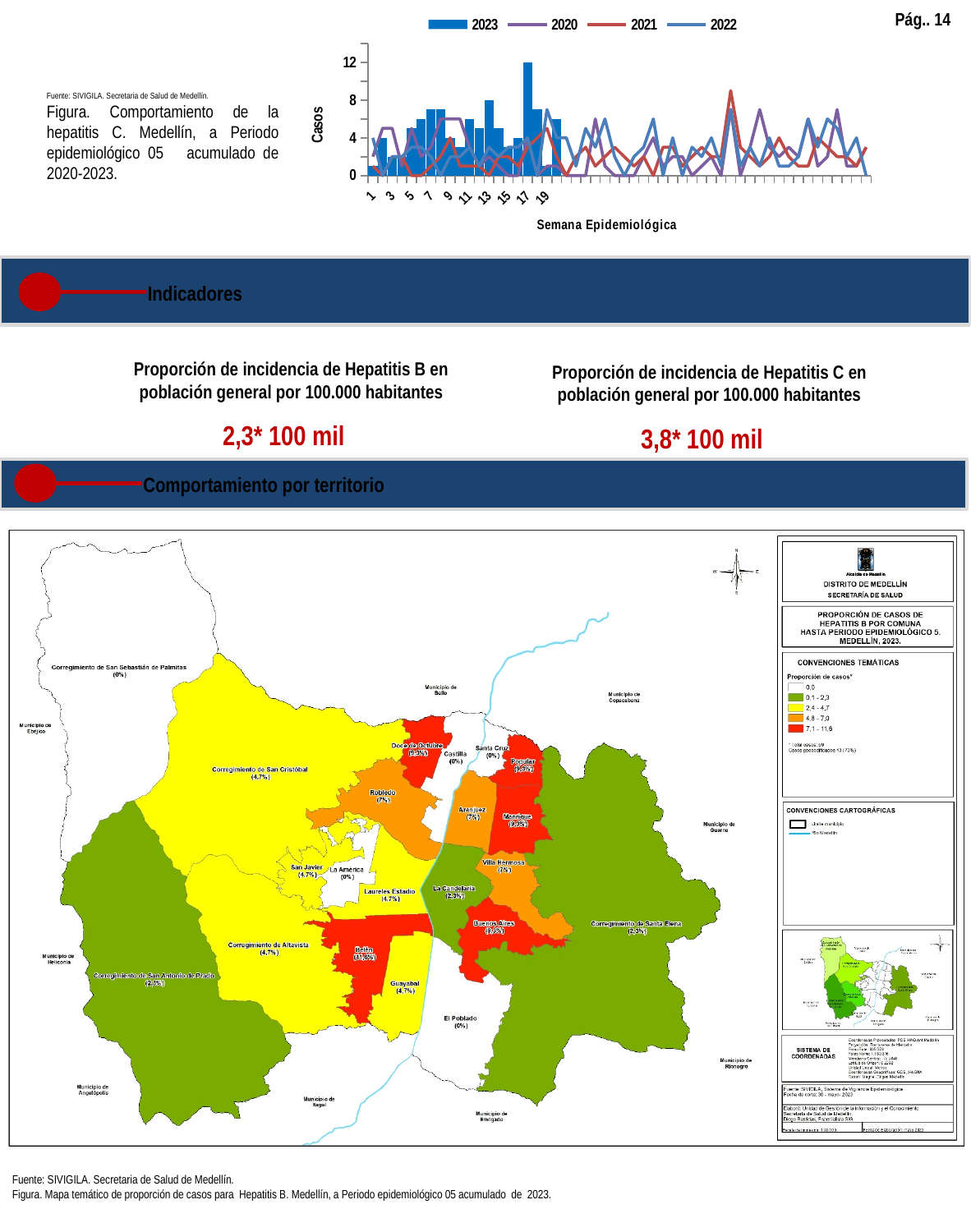
In the hepatitis C chart, which has the larger 2023 value: week 17 or week 3? week 17 In the hepatitis C chart, which epidemiological week has the highest 2023 bar? 17 How many series does the legend of the hepatitis C chart list? 4 What is the title of the vertical axis of the hepatitis C chart? Casos In the hepatitis C chart, is the 2023 value for week 17 greater or less than 8? greater In the hepatitis C chart, is the 2023 value for week 7 greater or less than 4? greater In the hepatitis C chart, is the 2023 value for week 3 greater or less than 4? less In the hepatitis C chart, which year is plotted as bars rather than a line? 2023 What kind of chart is used to show the hepatitis C cases by epidemiological week? bar and line chart